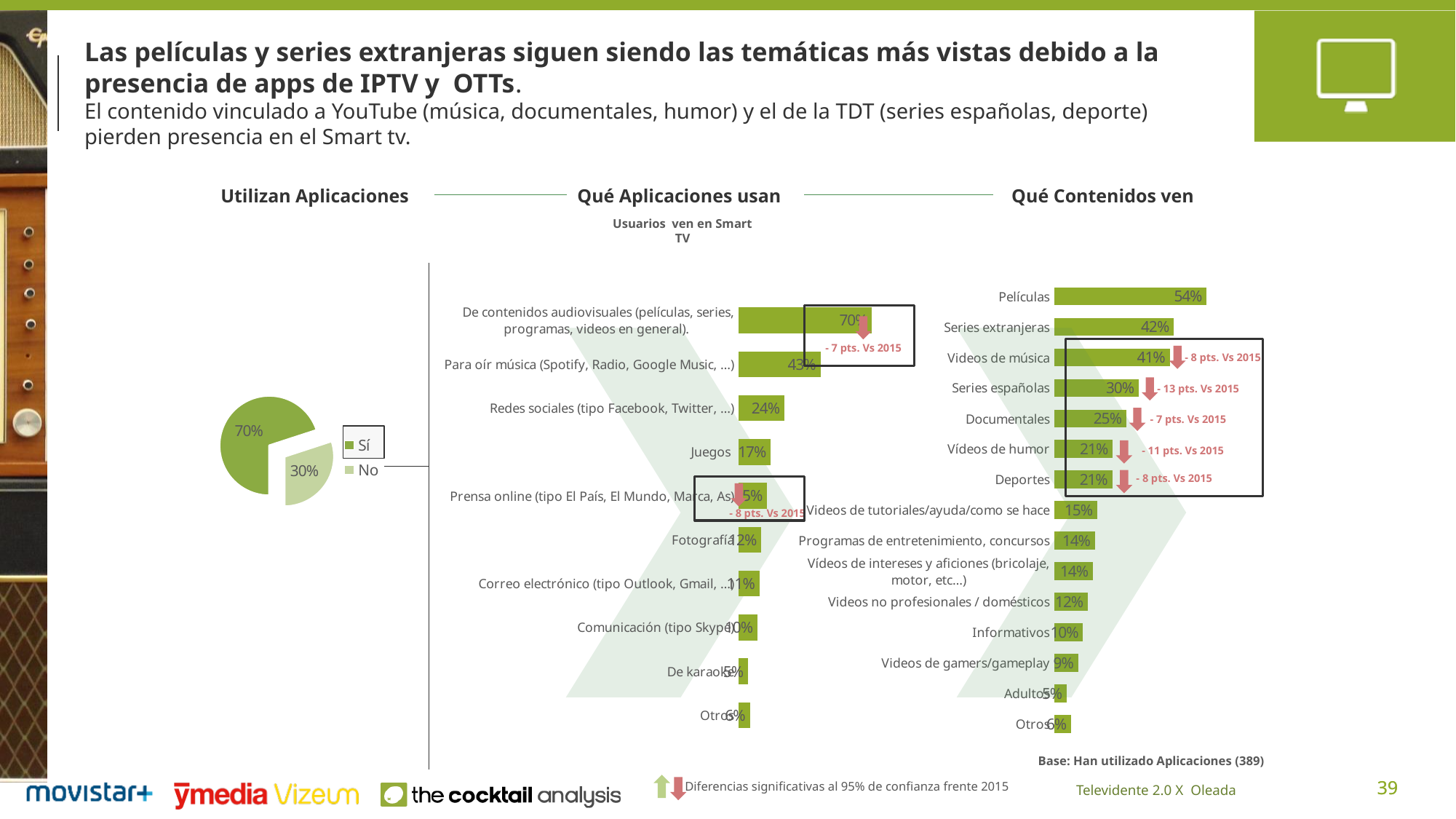
In the 'Qué Contenidos ven' chart, which is larger: 'Documentales' or 'Informativos'? Documentales In the 'Utilizan Aplicaciones' pie chart, what share of respondents answered 'Sí'? 70% How many categories are shown in the 'Qué Aplicaciones usan' chart? 10 In the 'Qué Contenidos ven' chart, what is the value for 'Series españolas'? 30% In the 'Qué Aplicaciones usan' chart, what is the value for 'Para oír música (Spotify, Radio, Google Music, ...)'? 43% In the 'Qué Aplicaciones usan' chart, which category has the highest value? De contenidos audiovisuales (películas, series, programas, videos en general). In the 'Qué Contenidos ven' chart, which category has the highest value? Películas In the 'Qué Contenidos ven' chart, what is the difference between 'Películas' and 'Series extranjeras'? 12 percentage points What kind of chart is the 'Qué Contenidos ven' chart? Bar chart In the 'Qué Aplicaciones usan' chart, what is the difference between 'Redes sociales' and 'Juegos'? 7 percentage points In the 'Qué Aplicaciones usan' chart, which category has the lowest value? De karaoke What kind of chart is the 'Utilizan Aplicaciones' chart? Pie chart